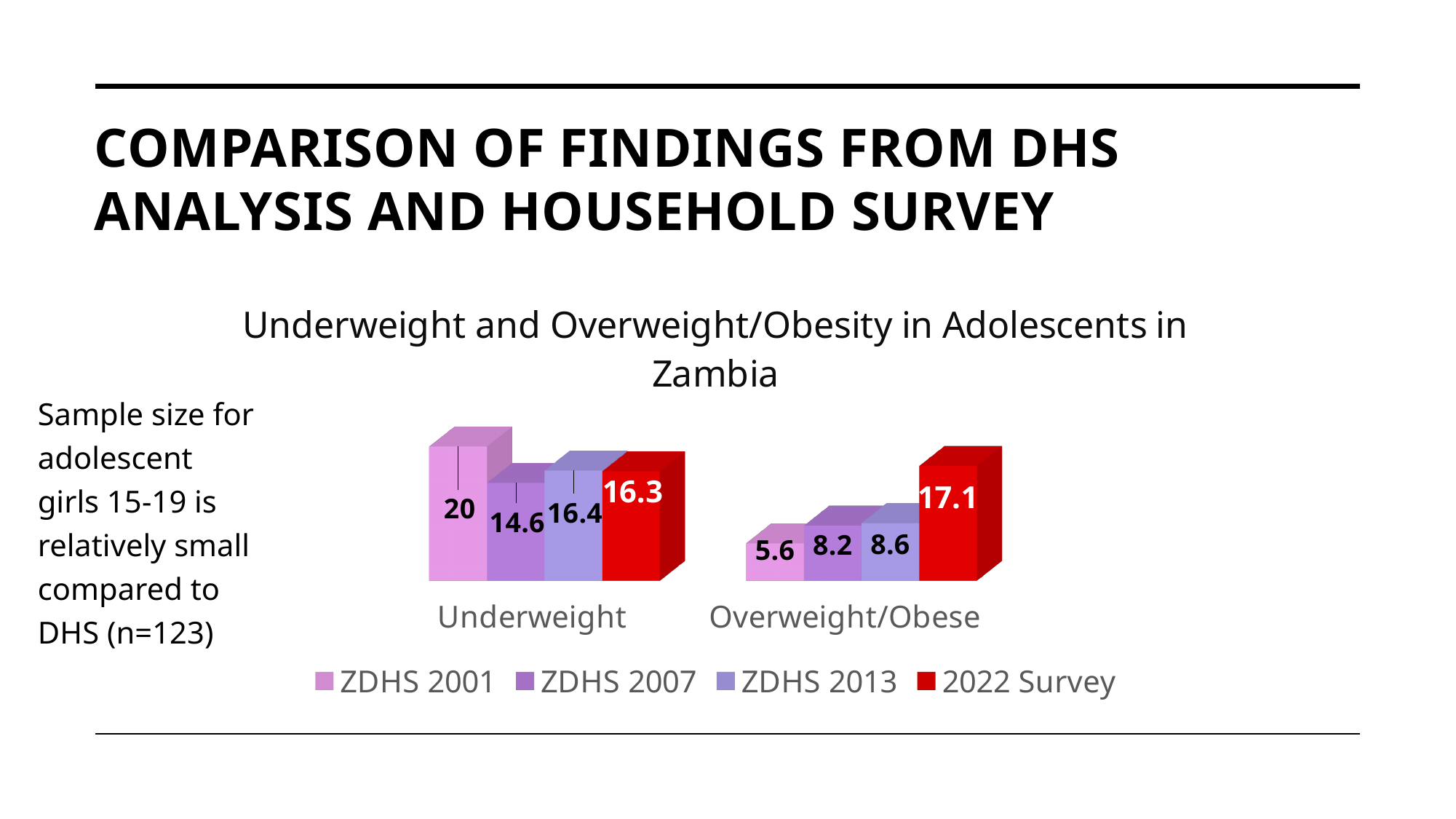
What kind of chart is shown on the slide? Bar chart What is the title of the chart? Underweight and Overweight/Obesity in Adolescents in Zambia What is the Underweight value for ZDHS 2013? 16.4 Which is larger: the Underweight value for ZDHS 2013 or the Underweight value for the 2022 Survey? ZDHS 2013 What is the difference between the Underweight values for ZDHS 2001 and ZDHS 2007? 5.4 What is the Overweight/Obese value for ZDHS 2007? 8.2 Which series has the highest Overweight/Obese value? 2022 Survey What is the Overweight/Obese value for the 2022 Survey? 17.1 What is the Underweight value for ZDHS 2001? 20 Which series has the lowest Underweight value? ZDHS 2007 What is the difference between the Overweight/Obese values for the 2022 Survey and ZDHS 2013? 8.5 How many series does the legend list? 4